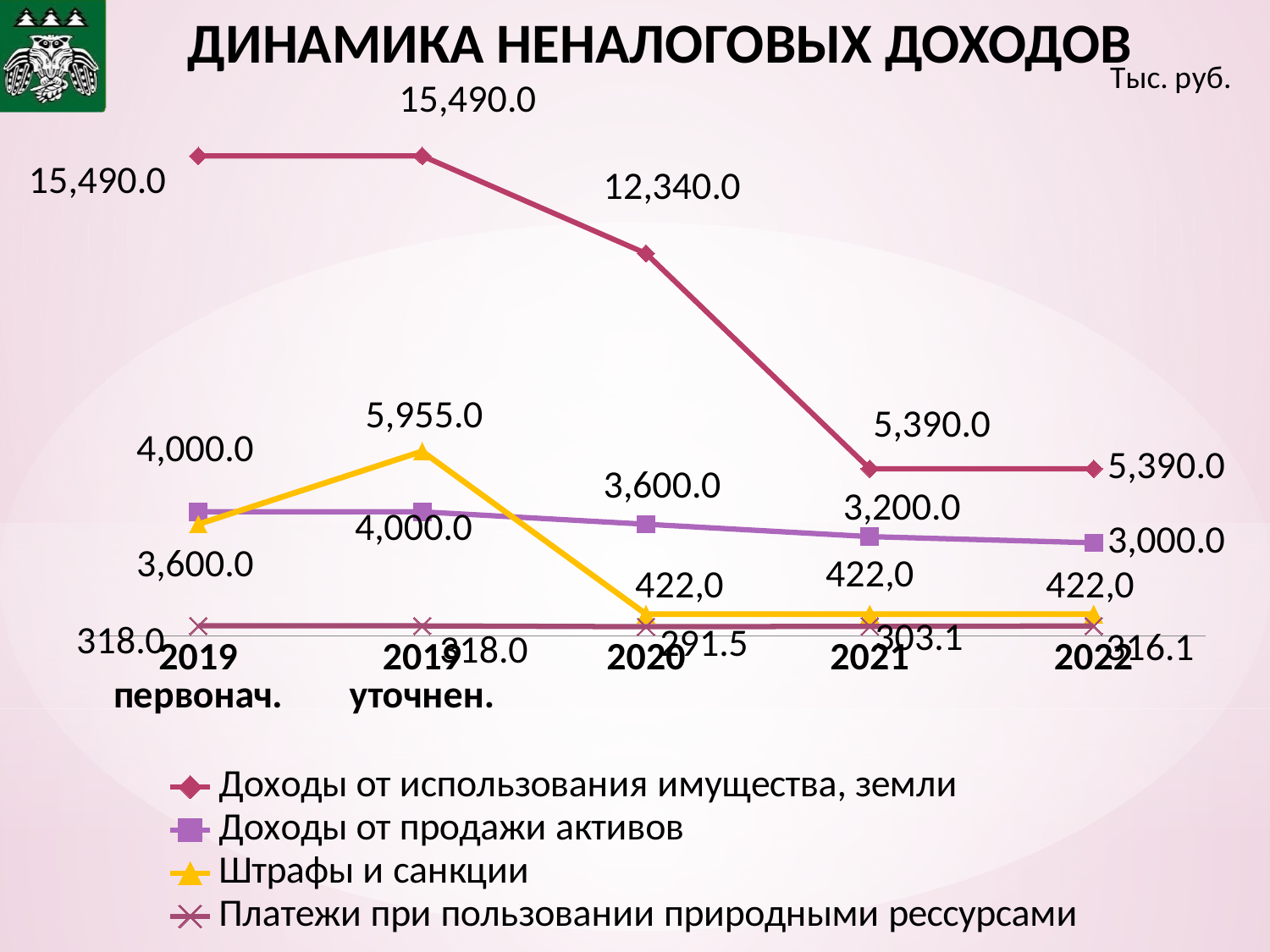
How many categories are shown along the x axis? 5 How many series does the legend list? 4 What is the value of 'Доходы от использования имущества, земли' for 2020? 12,340.0 What is the value of 'Штрафы и санкции' for 2019 уточнен.? 5,955.0 In which category is 'Доходы от продажи активов' lowest? 2022 What is the value of 'Доходы от продажи активов' for 2022? 3,000.0 Does 'Доходы от использования имущества, земли' rise or fall from 2019 уточнен. to 2021? fall What is the difference between the 'Доходы от использования имущества, земли' values for 2020 and 2021? 6,950.0 What type of chart is shown on the slide? line chart Which is larger in 2019 первонач.: 'Доходы от продажи активов' or 'Штрафы и санкции'? Доходы от продажи активов What is the value of 'Платежи при пользовании природными рессурсами' for 2020? 291.5 In which category does 'Штрафы и санкции' reach its highest value? 2019 уточнен.